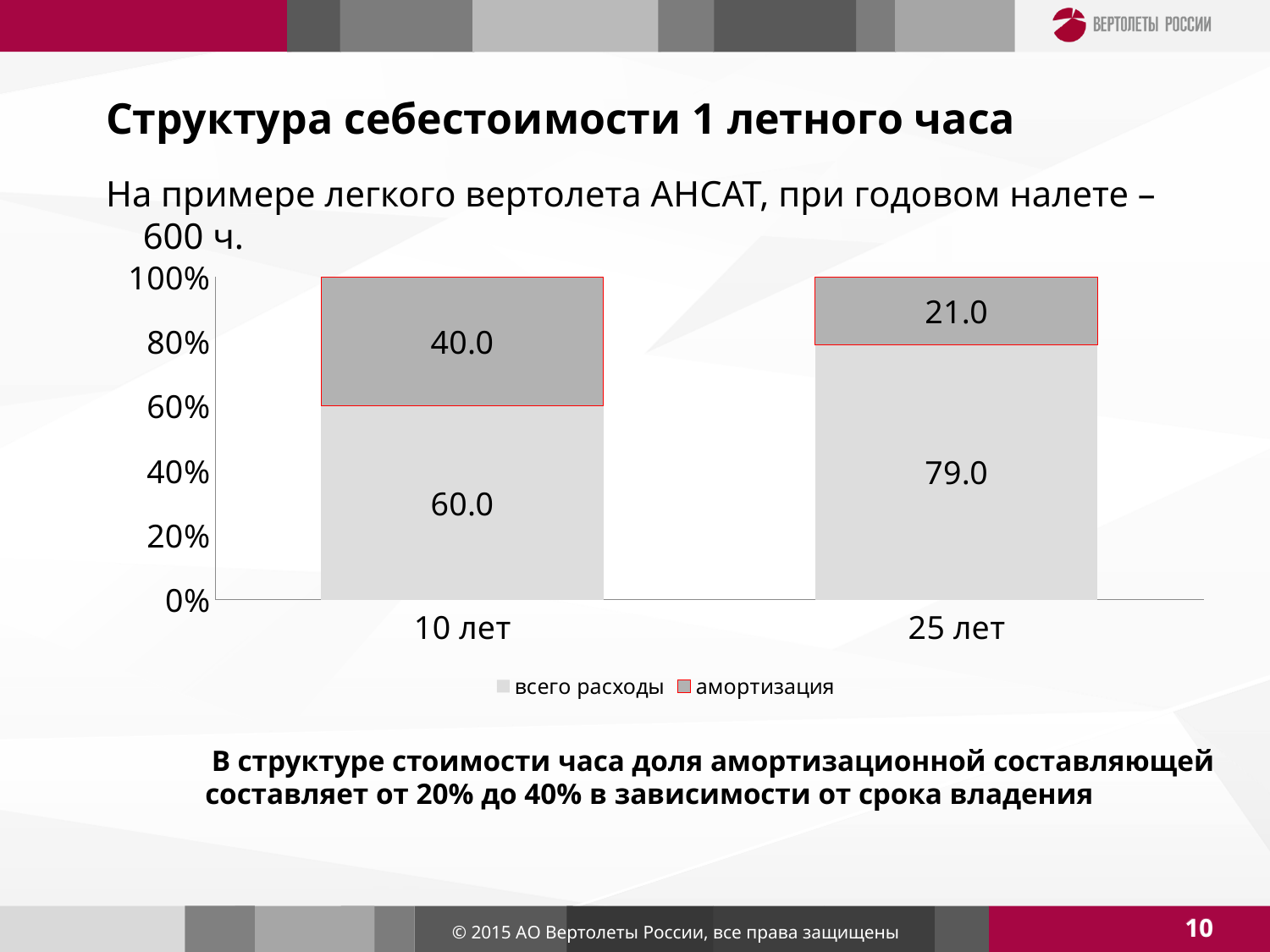
What is the value of амортизация for 25 лет? 21.0 What type of chart is shown on the slide? Stacked bar chart What is the value of всего расходы for 10 лет? 60.0 Which category has the higher value for амортизация, 10 лет or 25 лет? 10 лет What is the value of амортизация for 10 лет? 40.0 How many categories are shown on the x axis? 2 What is the total of the stacked bar for 10 лет? 100.0 Which category has the lowest value for всего расходы? 10 лет What is the difference between всего расходы and амортизация for 25 лет? 58.0 What is the difference between the амортизация values for 10 лет and 25 лет? 19.0 How many series does the legend list? 2 What is the value of всего расходы for 25 лет? 79.0